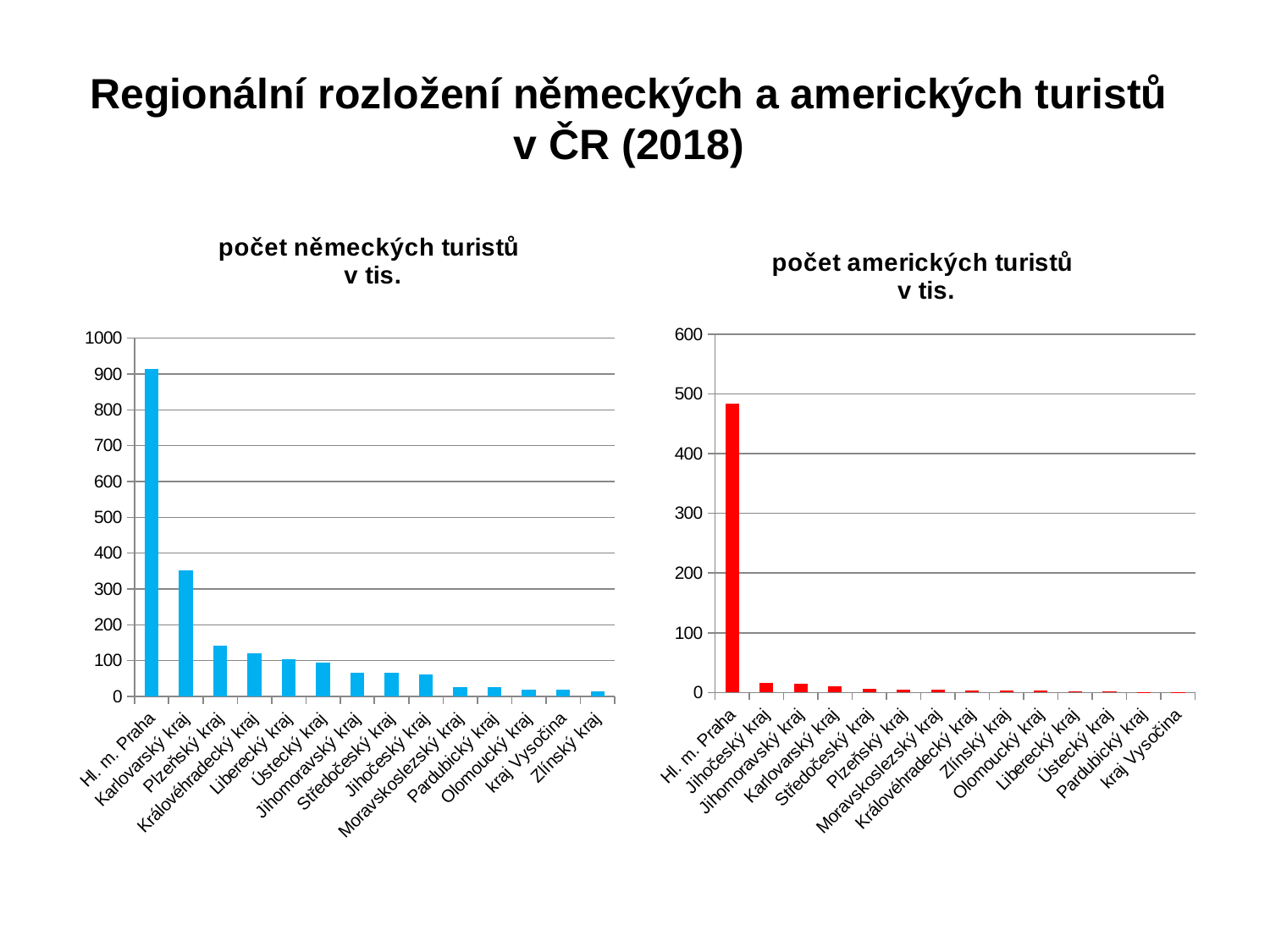
In the 'počet amerických turistů v tis.' chart, which region has the highest value? Hl. m. Praha In the 'počet německých turistů v tis.' chart, which is larger: Karlovarský kraj or Plzeňský kraj? Karlovarský kraj In the 'počet německých turistů v tis.' chart, is the value for Hl. m. Praha greater or less than 900? greater In the 'počet německých turistů v tis.' chart, is the value for Karlovarský kraj greater or less than 300? greater What type of chart is the 'počet německých turistů v tis.' chart? bar chart In the 'počet německých turistů v tis.' chart, which region has the highest value? Hl. m. Praha In the 'počet německých turistů v tis.' chart, do the values rise or fall from left to right along the x axis? fall What colour are the bars in the 'počet amerických turistů v tis.' chart? red In the 'počet amerických turistů v tis.' chart, is the value for Hl. m. Praha greater or less than 400? greater How many regions are shown in the 'počet amerických turistů v tis.' chart? 14